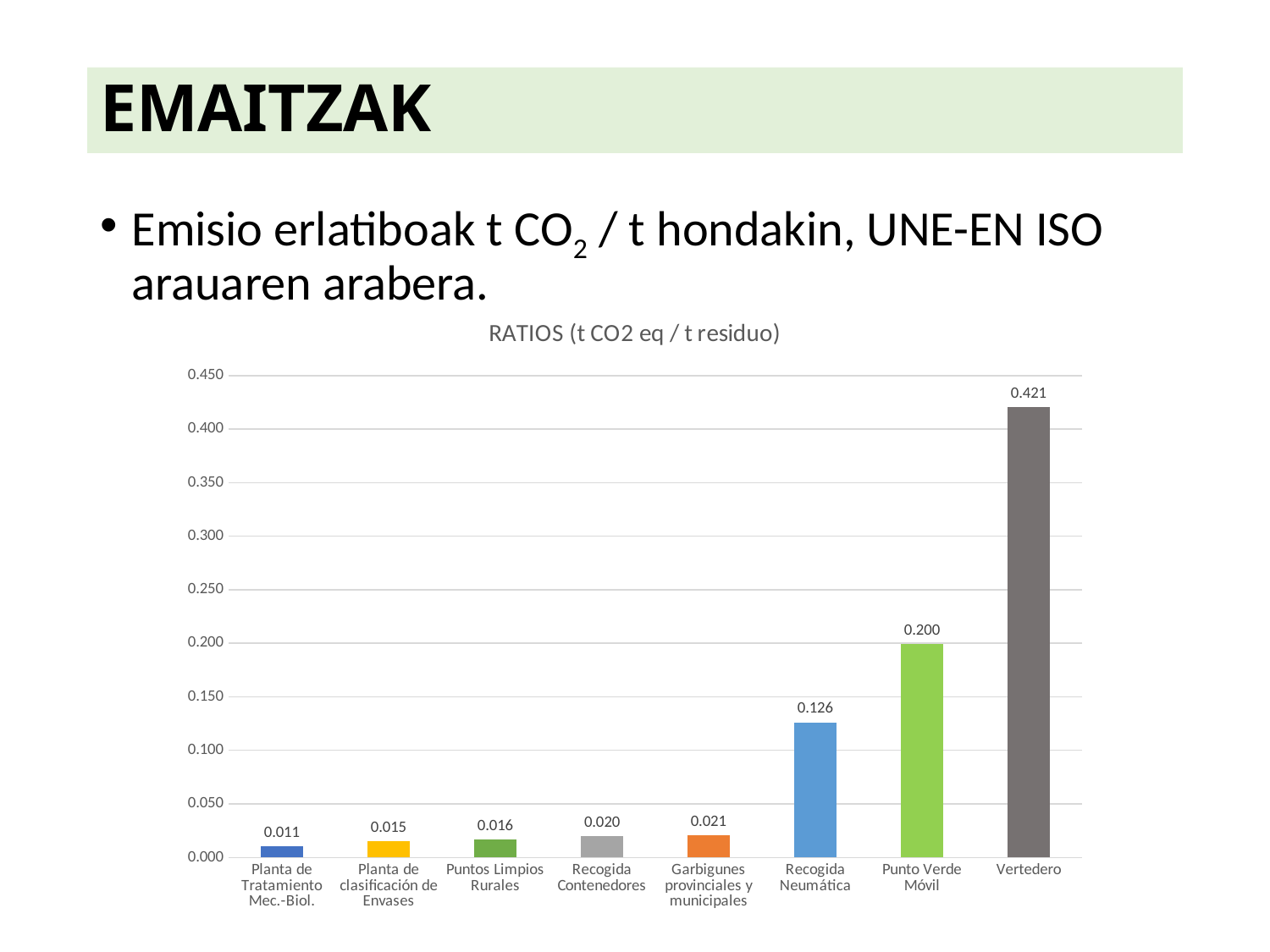
Which category has the lowest value? Planta de Tratamiento Mec.-Biol. Do the values rise or fall from left to right along the x axis? rise What is the value for Recogida Neumática? 0.126 Is the value for Vertedero greater or less than 0.400? greater What is the value for Vertedero? 0.421 Which category has the highest value? Vertedero What kind of chart is shown on the slide? bar chart How many categories are shown in the chart? 8 Which is larger, the value for Recogida Neumática or the value for Punto Verde Móvil? Punto Verde Móvil What is the title of the chart? RATIOS (t CO2 eq / t residuo) What is the value for Planta de clasificación de Envases? 0.015 What is the difference between the values for Vertedero and Punto Verde Móvil? 0.221